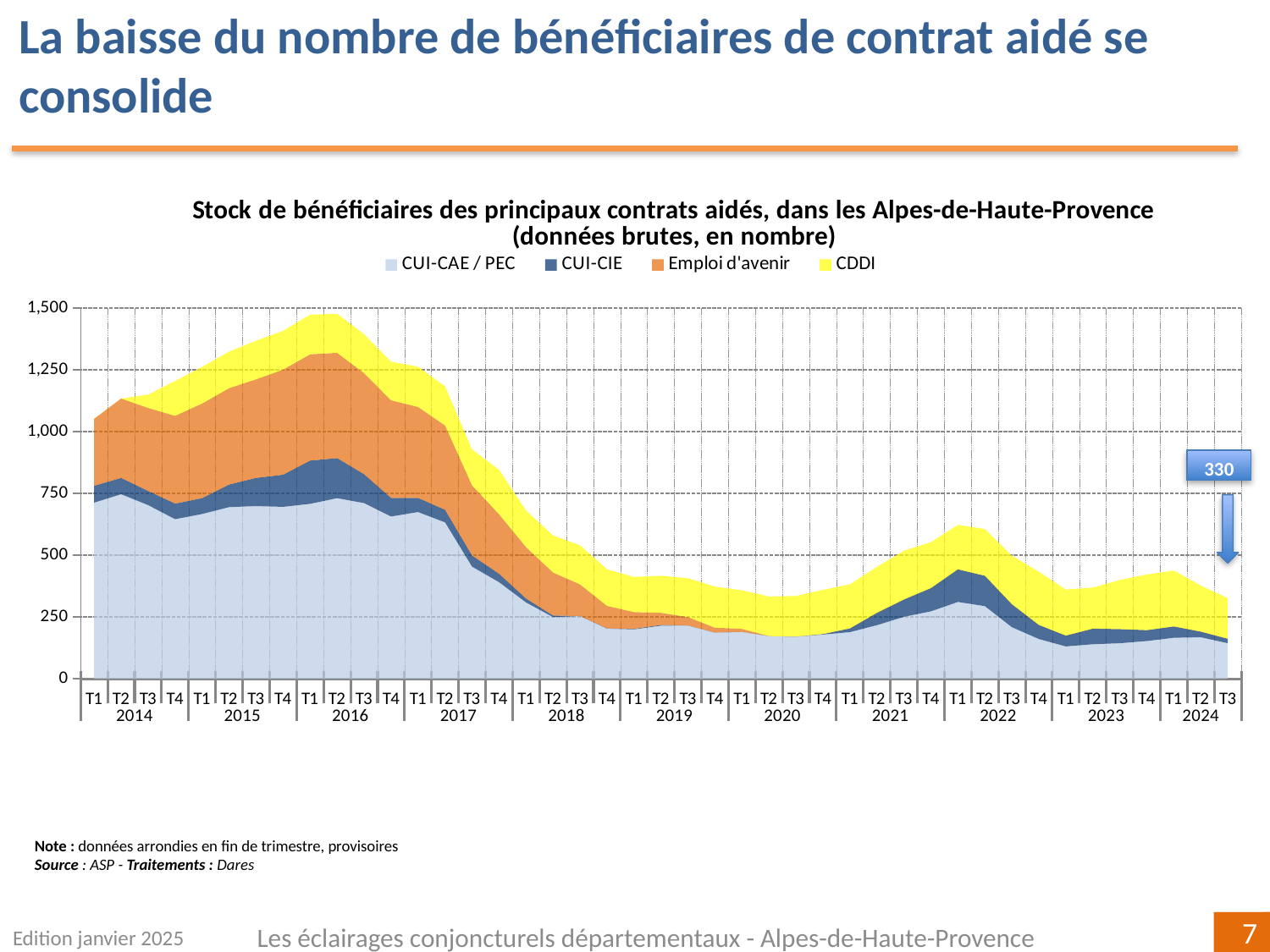
In which year does the total stock of beneficiaries reach its highest level? 2016 What kind of chart is shown on the slide? Stacked area chart Overall, does the total stock of beneficiaries rise or fall between 2014 and 2024? fall Is the total stock of beneficiaries in T3 2024 greater or less than 500? less Is the total stock of beneficiaries in T1 2016 greater or less than 1,250? greater Is the total stock of beneficiaries in T3 2020 greater or less than 500? less Which series is shown in yellow? CDDI What value is printed in the callout at the right end of the chart? 330 What is the first year shown on the x axis? 2014 Which is larger, the total stock in T1 2016 or in T1 2022? T1 2016 How many series does the legend list? 4